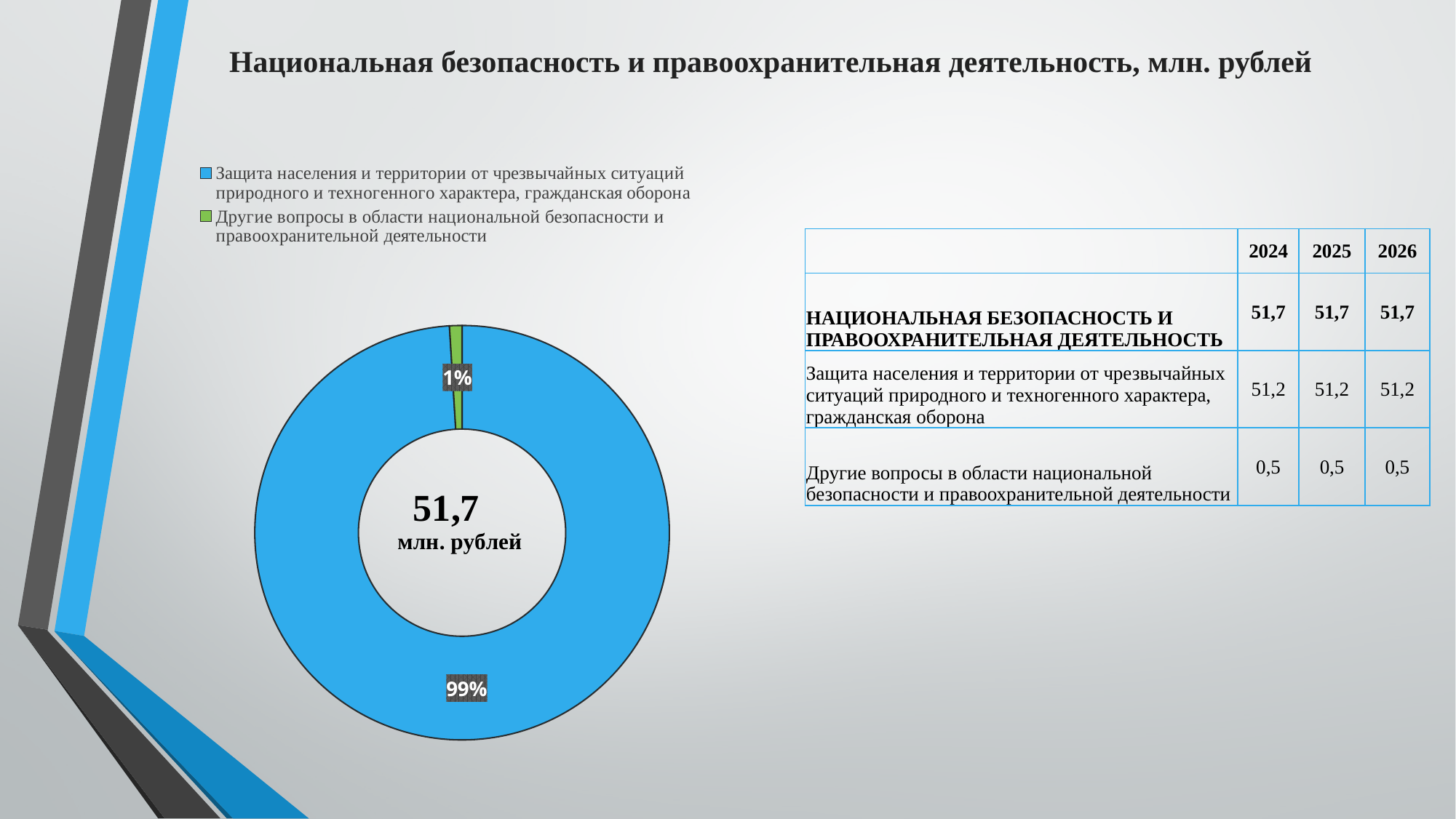
Which slice of the doughnut chart is the smallest? Другие вопросы в области национальной безопасности и правоохранительной деятельности What is the title of the slide containing the doughnut chart? Национальная безопасность и правоохранительная деятельность, млн. рублей What total value is printed in the centre of the doughnut chart? 51,7 млн. рублей What share of the doughnut chart does the slice "Другие вопросы в области национальной безопасности и правоохранительной деятельности" take? 1% How many slices does the doughnut chart have? 2 What is the difference in percentage points between the 99% slice and the 1% slice of the doughnut chart? 98 percentage points Which slice is larger: "Защита населения и территории от чрезвычайных ситуаций..." or "Другие вопросы в области национальной безопасности..."? Защита населения и территории от чрезвычайных ситуаций природного и техногенного характера, гражданская оборона What colour is the slice for "Другие вопросы в области национальной безопасности и правоохранительной деятельности" in the doughnut chart? Green What kind of chart is shown on the slide? Doughnut (pie) chart Which slice of the doughnut chart is the largest? Защита населения и территории от чрезвычайных ситуаций природного и техногенного характера, гражданская оборона How many entries does the legend of the doughnut chart list? 2 What share of the doughnut chart does the slice "Защита населения и территории от чрезвычайных ситуаций природного и техногенного характера, гражданская оборона" take? 99%